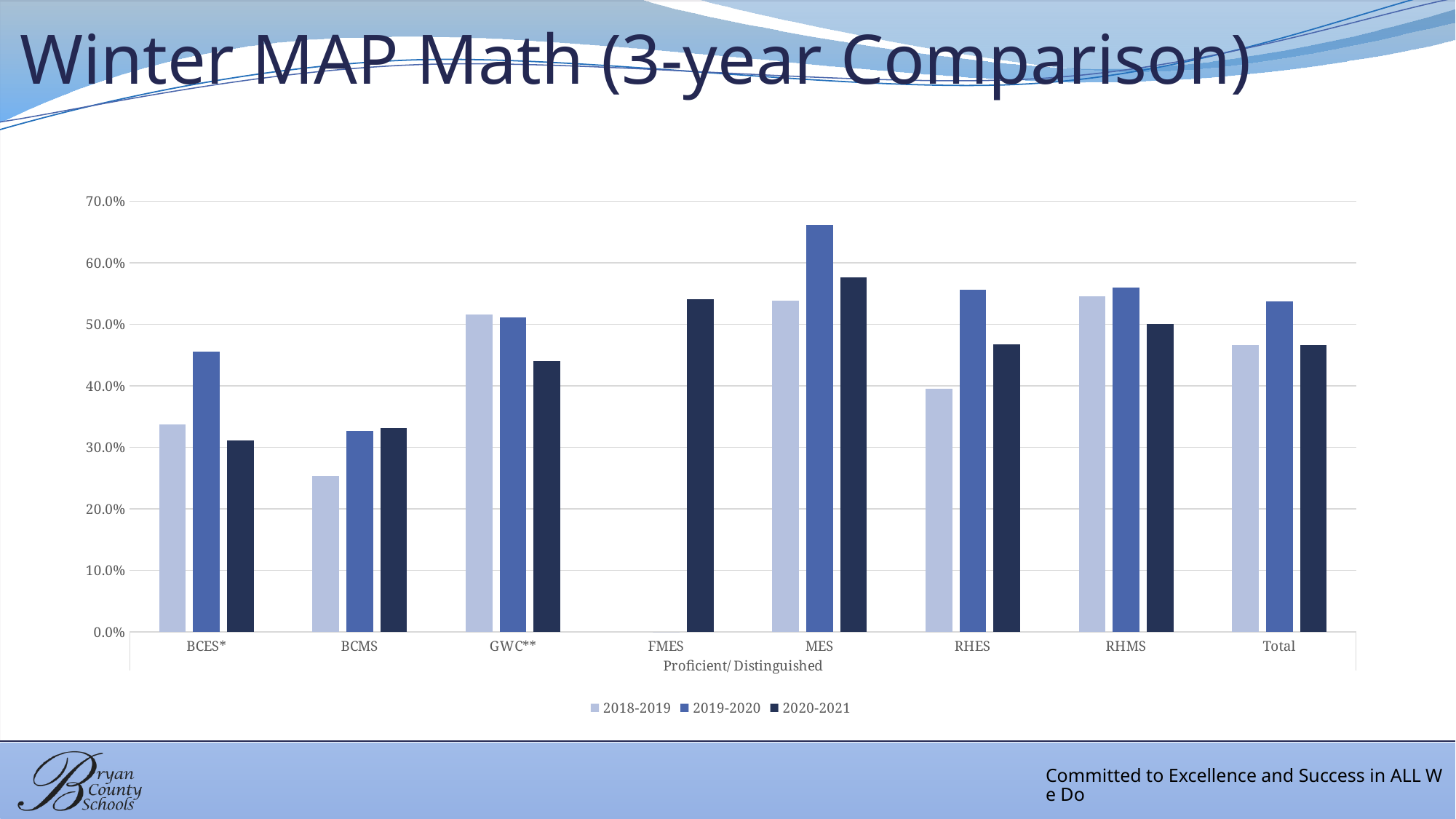
What kind of chart is shown on the slide? bar chart Which category and series has the lowest bar in the chart? BCMS, 2018-2019 Is the 2020-2021 value for FMES greater or less than 50.0%? greater Which is larger: the 2020-2021 value for GWC** or the 2020-2021 value for BCES*? GWC** Is the 2018-2019 value for BCMS greater or less than 30.0%? less Is the 2019-2020 value for BCES* greater or less than 40.0%? greater Which category has a bar for only one of the three series? FMES For RHES, which is larger: the 2018-2019 value or the 2019-2020 value? 2019-2020 What is the label shown beneath the x axis of the chart? Proficient/ Distinguished How many series does the legend list? 3 Which category and series has the highest bar in the chart? MES, 2019-2020 How many categories are shown along the x axis? 8